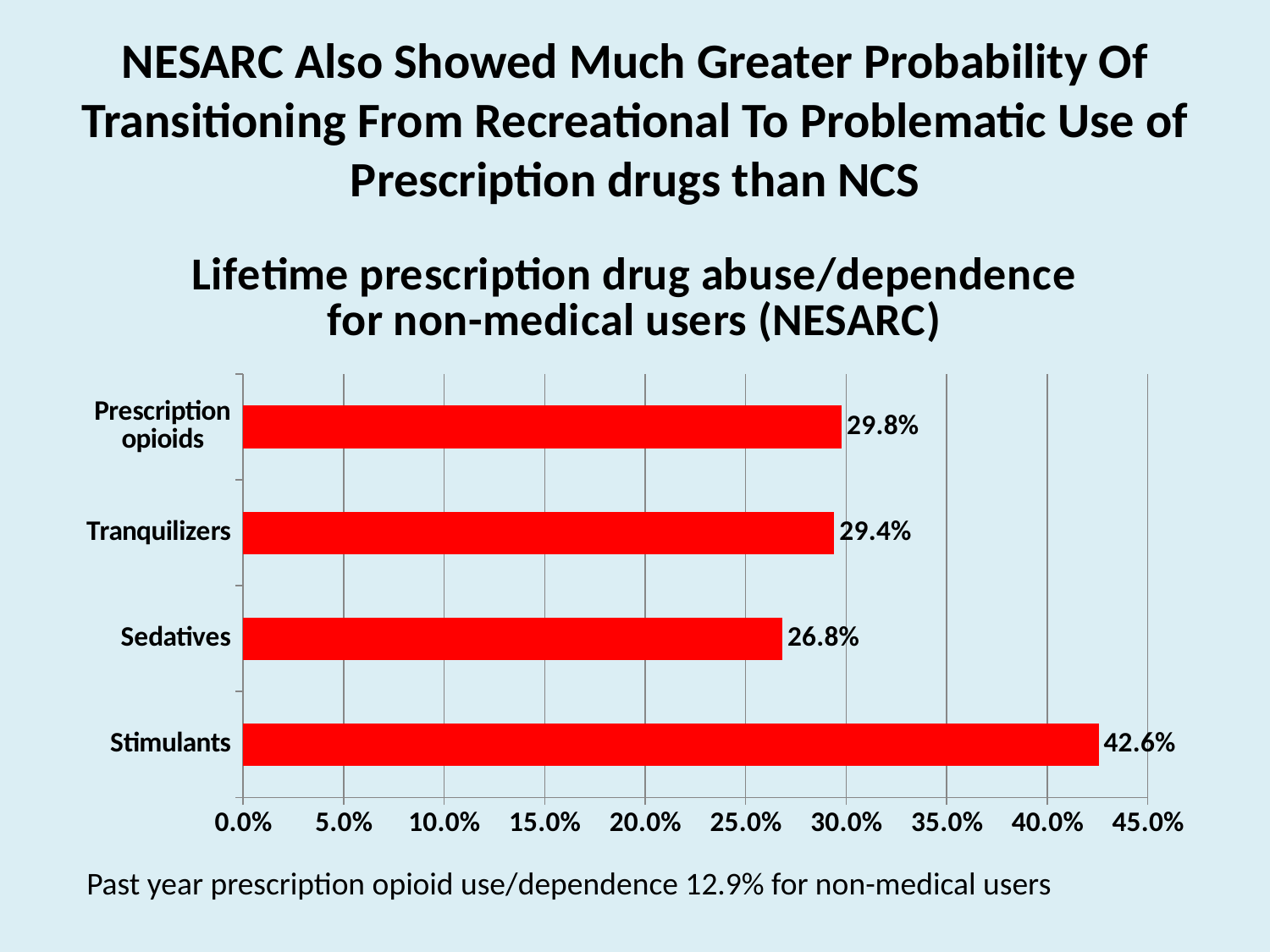
Which category has the lowest value? Sedatives What kind of chart is shown on the slide? Bar chart Is the value for Sedatives greater or less than 30.0%? less What is the value for Sedatives? 26.8% What is the value for Tranquilizers? 29.4% Which is larger, the value for Stimulants or the value for Prescription opioids? Stimulants What is the difference between the values for Stimulants and Sedatives? 15.8% How many categories are shown in the chart? 4 What is the value for Stimulants? 42.6% What is the value for Prescription opioids? 29.8% Which category has the highest value? Stimulants What is the difference between the values for Prescription opioids and Tranquilizers? 0.4%